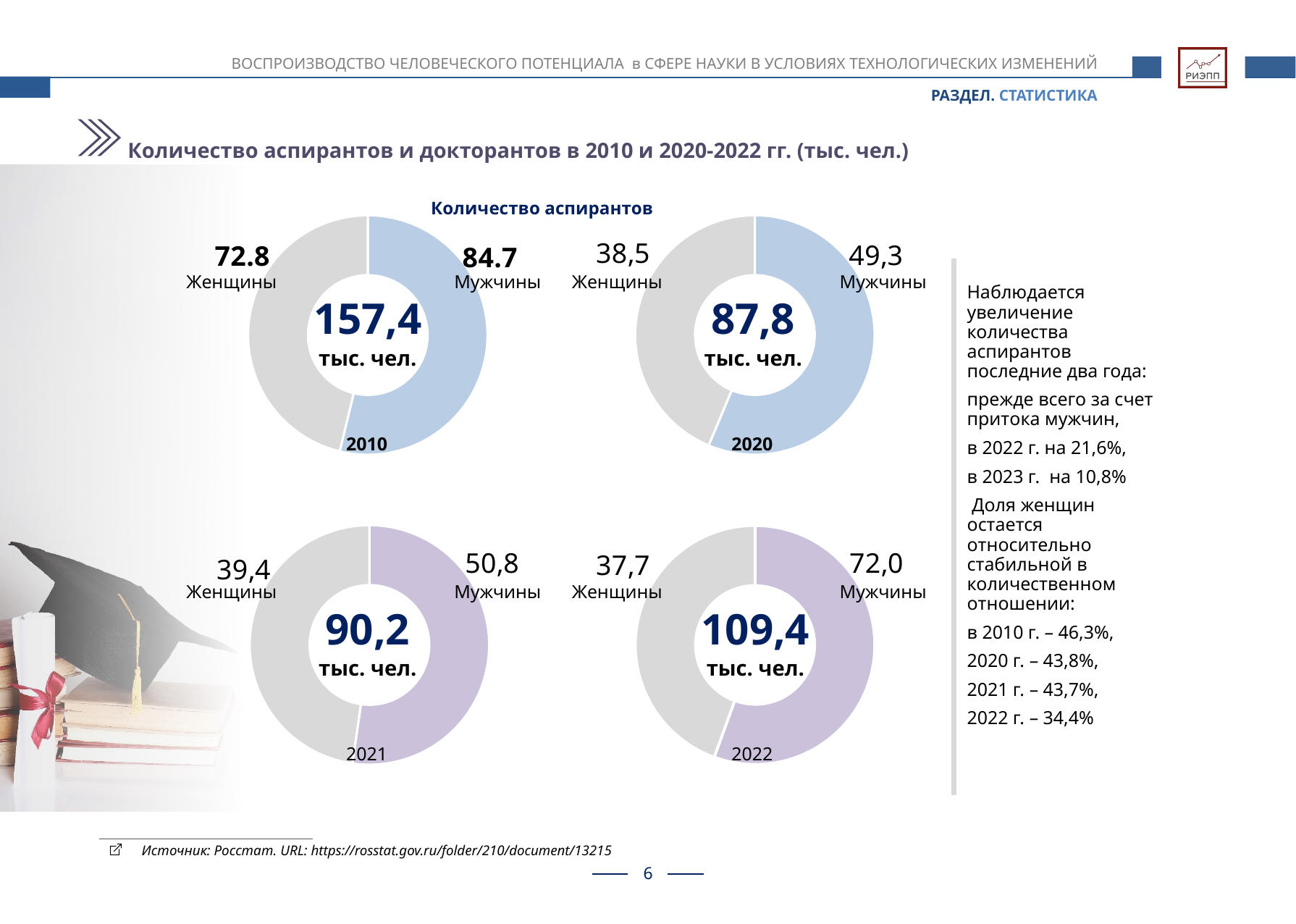
In the 2010 donut chart, what is the difference between Мужчины and Женщины? 11.9 What total is shown in the centre of the 2022 donut chart? 109,4 тыс. чел. In the 2022 donut chart, which is larger, Женщины or Мужчины? Мужчины In the 2022 donut chart, what is the difference between Мужчины and Женщины? 34,3 What type of chart is used to show the number of аспиранты for each year? Donut (pie) chart In the 2022 donut chart, what is the value for Женщины? 37,7 In the 2010 donut chart, what is the value for Мужчины? 84.7 What total is shown in the centre of the 2020 donut chart? 87,8 тыс. чел. Which of the four donut charts shows the highest total number of аспиранты? 2010 How many donut charts are shown on the slide? 4 In the 2021 donut chart, what is the value for Мужчины? 50,8 Which of the four donut charts shows the lowest total number of аспиранты? 2020